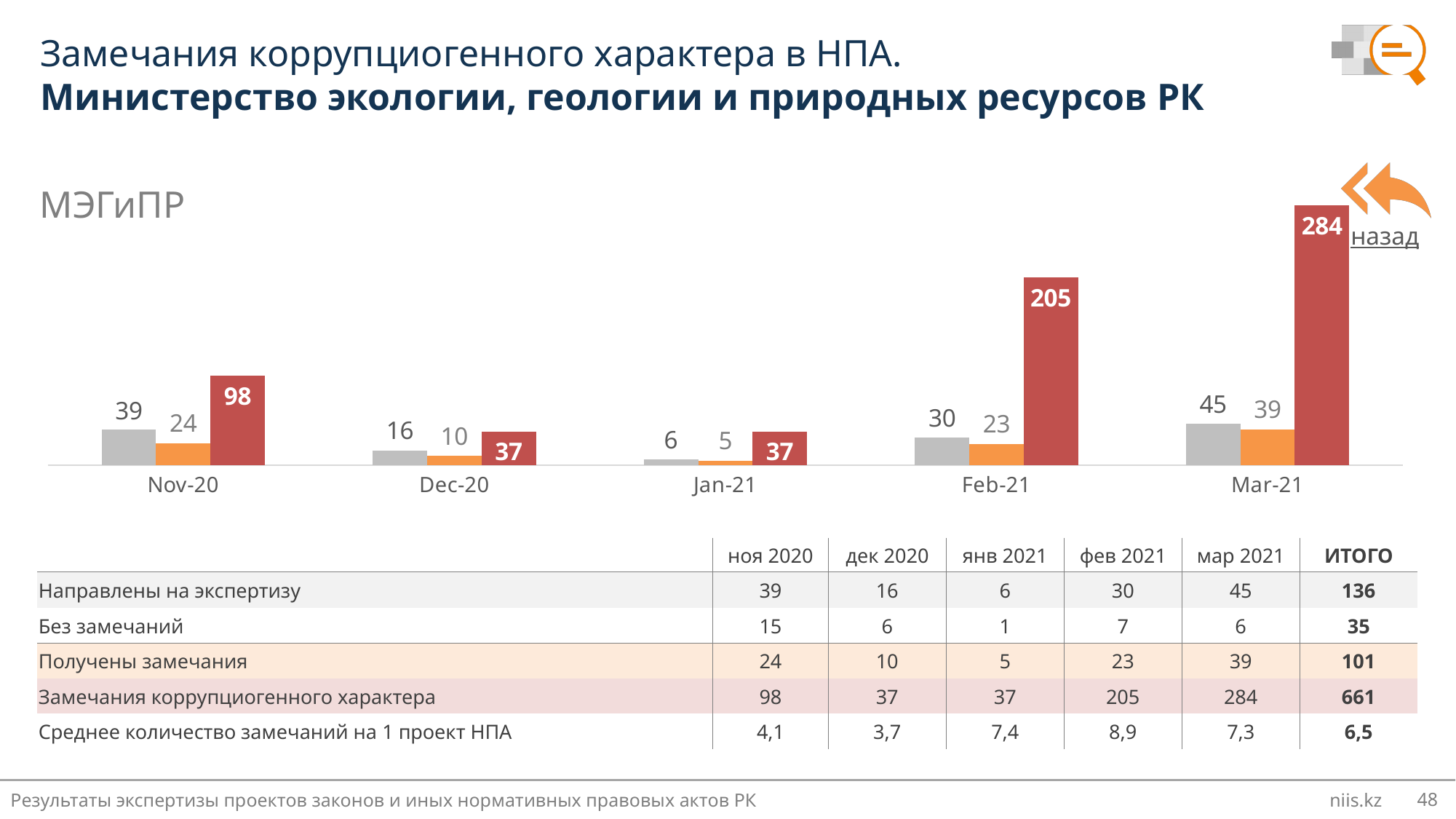
What type of chart is shown on the slide? bar chart Which is larger: the red bar for Nov-20 or the red bar for Dec-20? Nov-20 What is the difference between the red bar values for Mar-21 and Feb-21? 79 Do the red bar values rise or fall from Jan-21 to Mar-21? rise What is the value of the red bar for Mar-21? 284 How many months (categories) are shown on the x axis of the chart? 5 In which month is the grey bar the lowest? Jan-21 What is the value of the grey bar for Nov-20? 39 In which month is the red bar the highest? Mar-21 What is the value of the orange bar for Feb-21? 23 How many bars are shown for each month in the chart? 3 What is the difference between the grey bar and the orange bar for Dec-20? 6